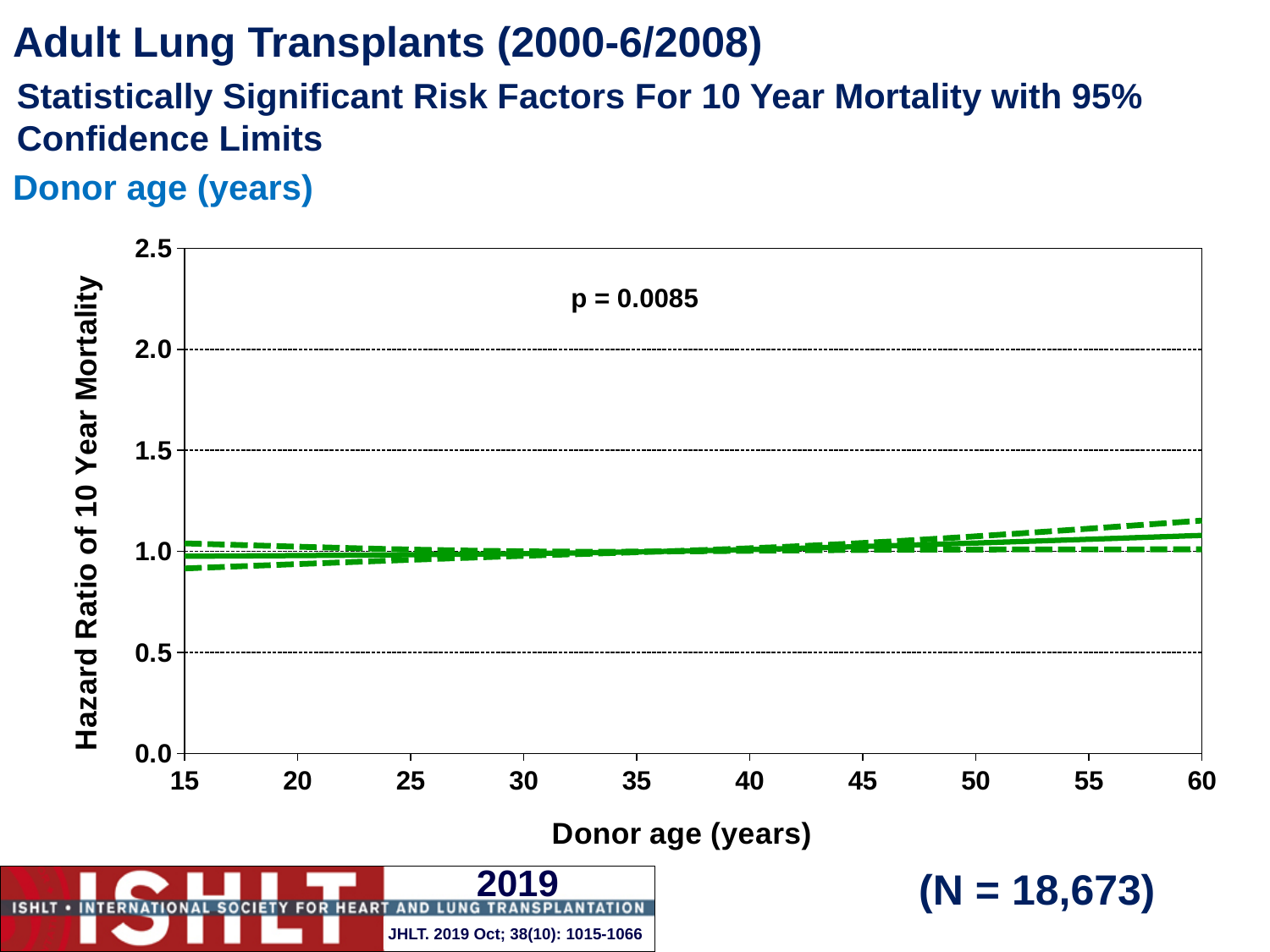
Is the hazard ratio at a donor age of 15 years greater or less than 0.5? greater What is the label of the x axis? Donor age (years) What is the range of donor ages shown on the x axis? 15 to 60 Does the hazard ratio rise or fall as donor age increases from 15 to 60 years? rise Is the upper confidence limit at a donor age of 60 years greater or less than 2.0? less Is the hazard ratio at a donor age of 60 years greater or less than 1.5? less What is the label of the y axis? Hazard Ratio of 10 Year Mortality What kind of chart is shown on the slide? line chart